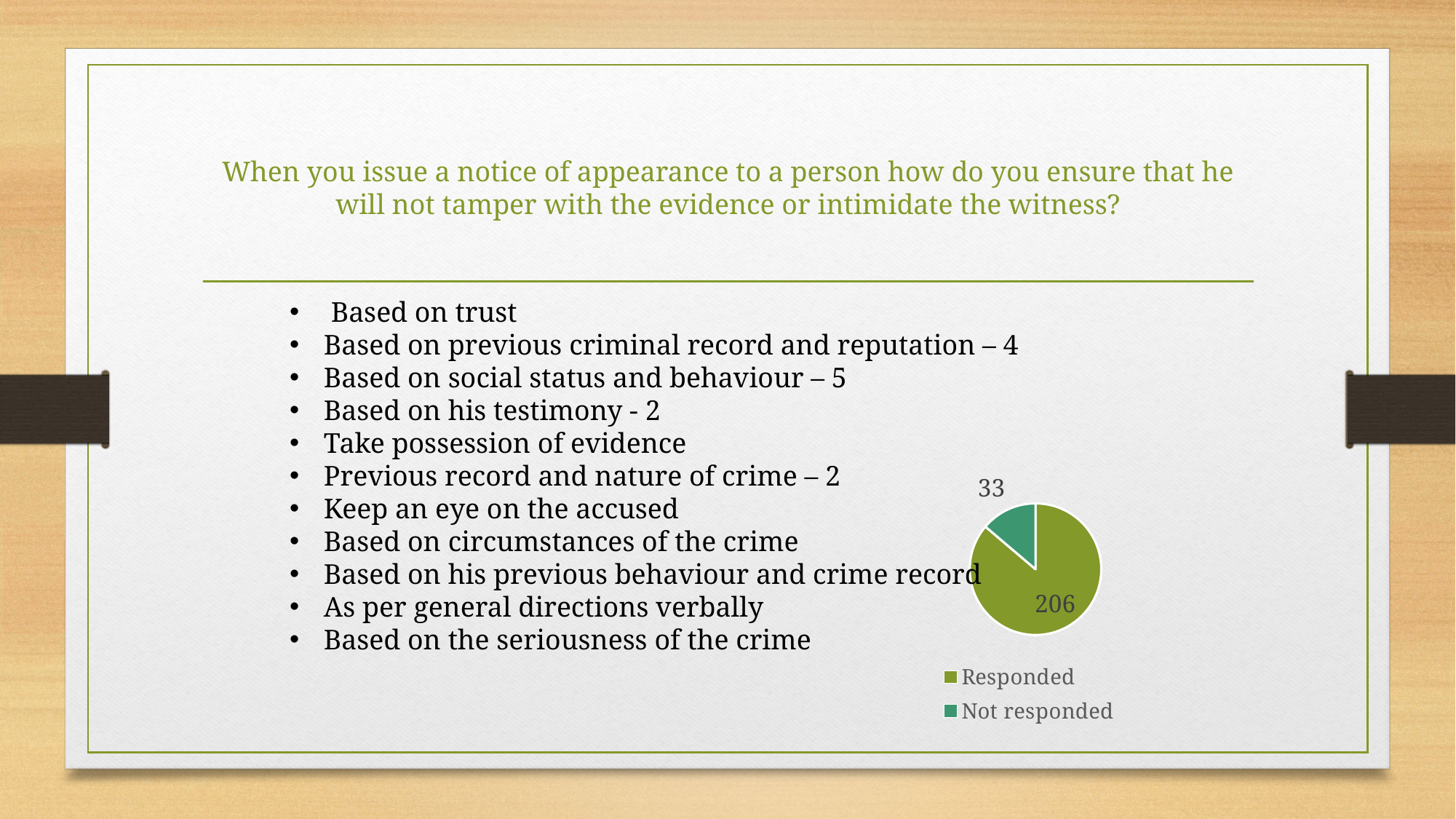
What is the value for Responded in the pie chart? 206 What is the total of all slices in the pie chart? 239 Which category has the smallest slice in the pie chart? Not responded What colour is the Not responded slice in the pie chart? teal green How many slices does the pie chart have? 2 What share of the pie does the Responded slice represent? 86.2% Which is larger, Responded or Not responded? Responded Which category has the largest slice in the pie chart? Responded What is the difference between the Responded and Not responded values? 173 How many entries does the legend of the pie chart list? 2 What is the value for Not responded in the pie chart? 33 What kind of chart is shown on the slide? pie chart